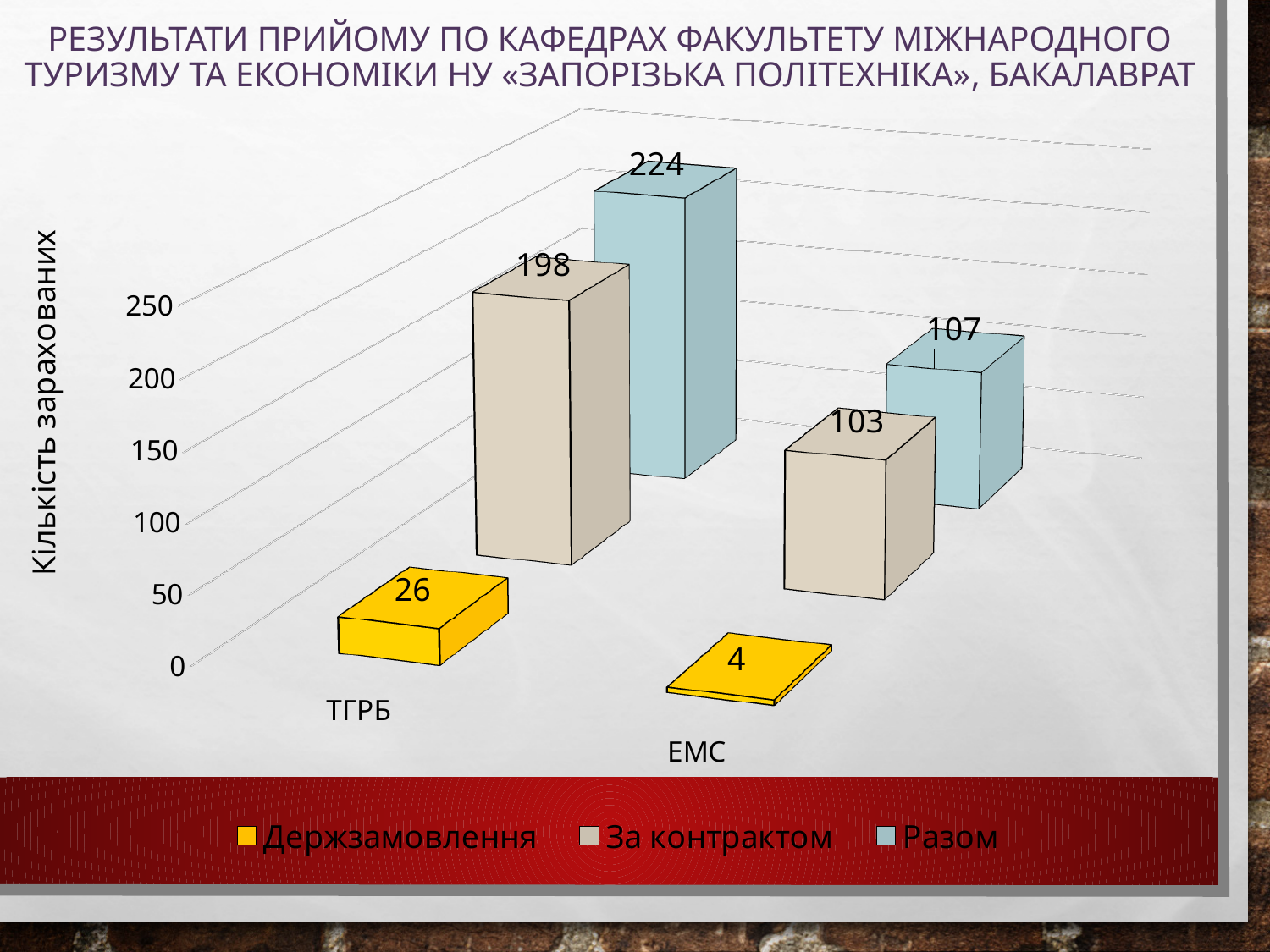
Which category has the highest value for Разом? ТГРБ How many series does the legend list? 3 What is the label of the vertical axis? Кількість зарахованих What is the difference between the За контрактом values for ТГРБ and ЕМС? 95 What is the value for Держзамовлення for ЕМС? 4 How many categories are shown on the x axis? 2 Which is larger: Разом for ЕМС or За контрактом for ТГРБ? За контрактом for ТГРБ What kind of chart is shown on the slide? Bar chart Which category has the lowest value for Держзамовлення? ЕМС What is the value for За контрактом for ЕМС? 103 What is the value for Разом for ТГРБ? 224 What is the value for Держзамовлення for ТГРБ? 26